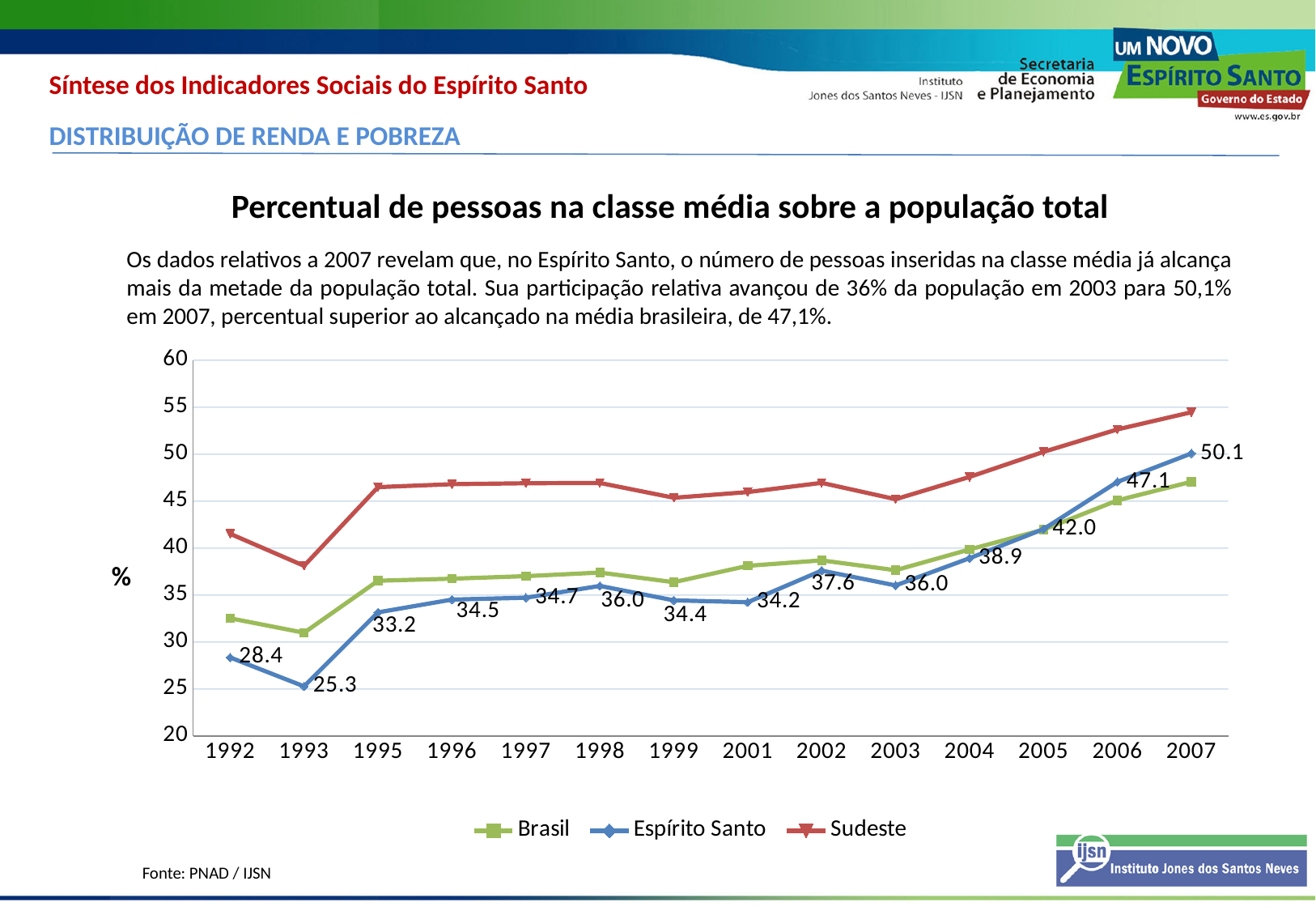
Which series has the higher value in 2007, Sudeste or Brasil? Sudeste Does the Espírito Santo series rise or fall from 2003 to 2007? rise What kind of chart is shown on the slide? line chart What is the value for Espírito Santo in 2007? 50.1 Is the value for Brasil in 1993 greater or less than 35? less How many years are shown along the x axis? 14 What is the value for Espírito Santo in 1992? 28.4 How many series does the legend list? 3 What is the value for Espírito Santo in 1993? 25.3 In which year is the Espírito Santo series at its lowest? 1993 What is the difference between the Espírito Santo values for 2007 and 1992? 21.7 In which year is the Espírito Santo series at its highest? 2007